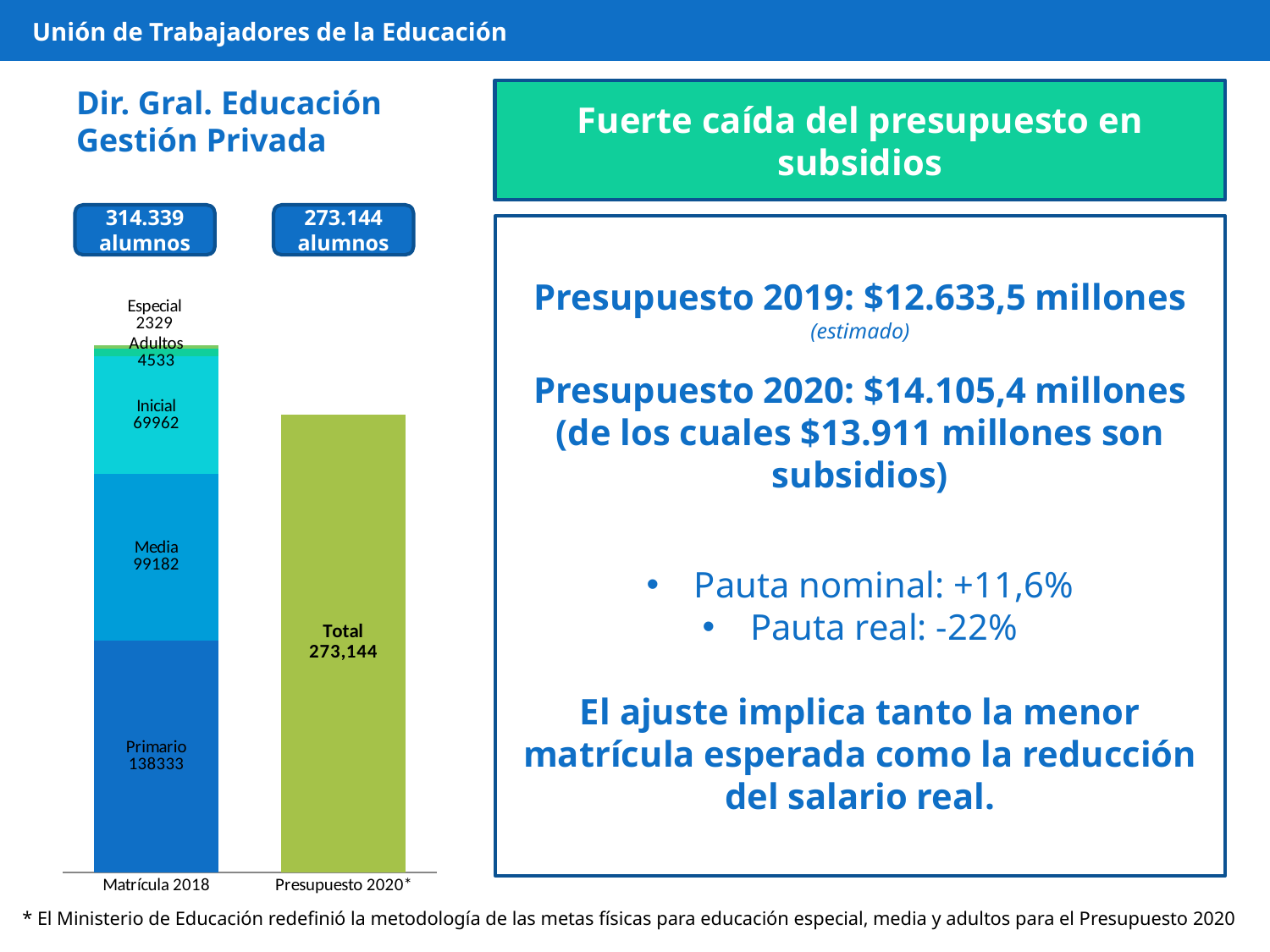
What is the difference between the Primario and Media segments in the Matrícula 2018 bar? 39151 What is the value of the Primario segment in the Matrícula 2018 bar? 138333 What kind of chart is shown on the left of the slide? stacked bar chart What is the value of the Especial segment in the Matrícula 2018 bar? 2329 Which segment of the Matrícula 2018 bar has the largest value? Primario What is the total shown for the Presupuesto 2020* bar? 273,144 What is the value of the Media segment in the Matrícula 2018 bar? 99182 What is the value of the Adultos segment in the Matrícula 2018 bar? 4533 How many bars (categories) does the chart show along the x axis? 2 What is the value of the Inicial segment in the Matrícula 2018 bar? 69962 Which segment of the Matrícula 2018 bar has the smallest value? Especial What is the total of the Matrícula 2018 stacked bar, as labelled above it? 314.339 alumnos